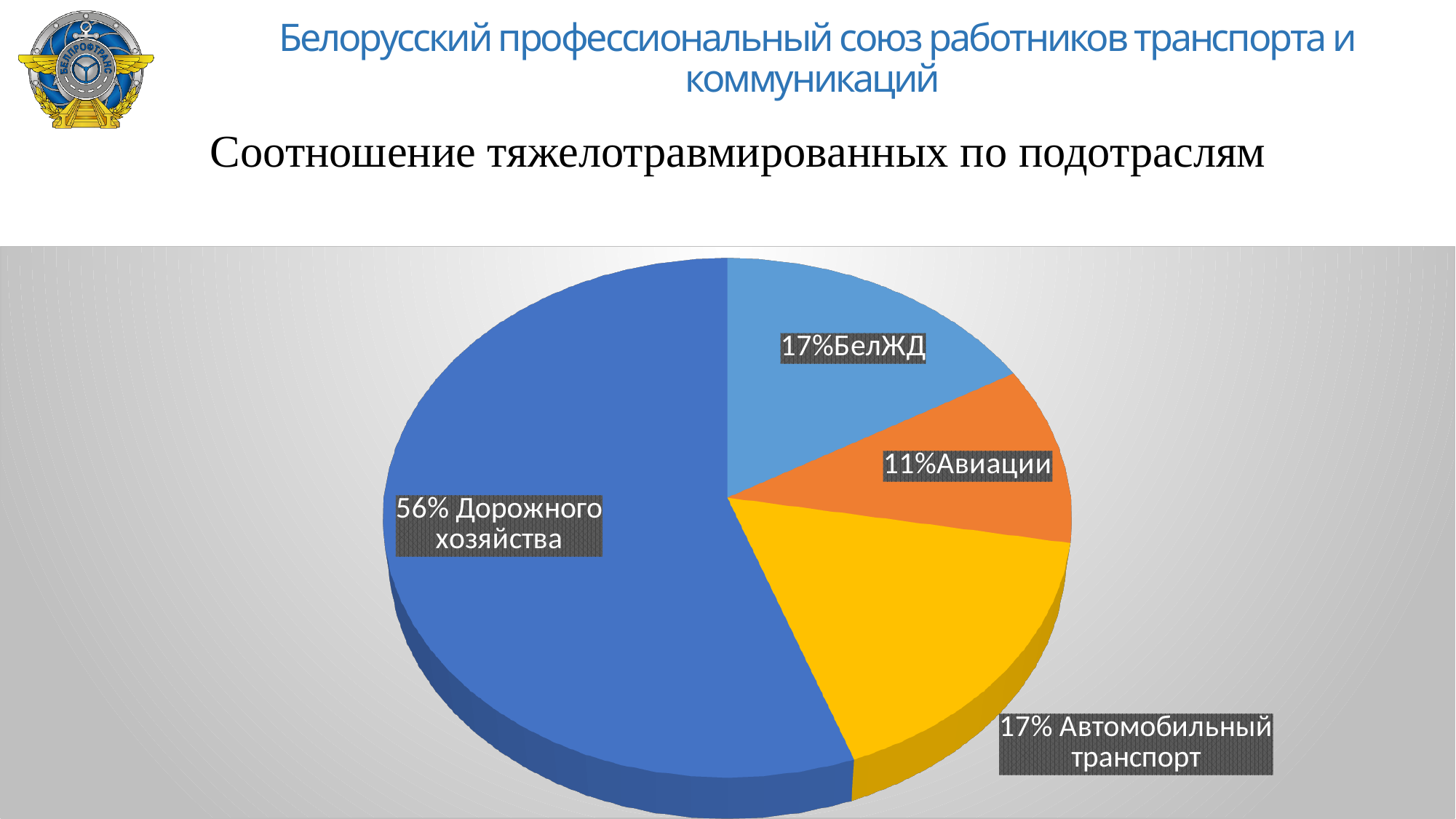
What is the title of the chart on the slide? Соотношение тяжелотравмированных по подотраслям What share of the pie does Автомобильный транспорт hold? 17% What share of the pie does Авиации hold? 11% How many slices does the pie chart have? 4 What kind of chart is shown on the slide? Pie chart What share of the pie does БелЖД hold? 17% Which is larger, the share of Дорожного хозяйства or the share of Автомобильный транспорт? Дорожного хозяйства Which category has the smallest slice of the pie? Авиации What is the difference between the shares of Дорожного хозяйства and Авиации? 45% What is the difference between the shares of БелЖД and Авиации? 6% Which category has the largest slice of the pie? Дорожного хозяйства